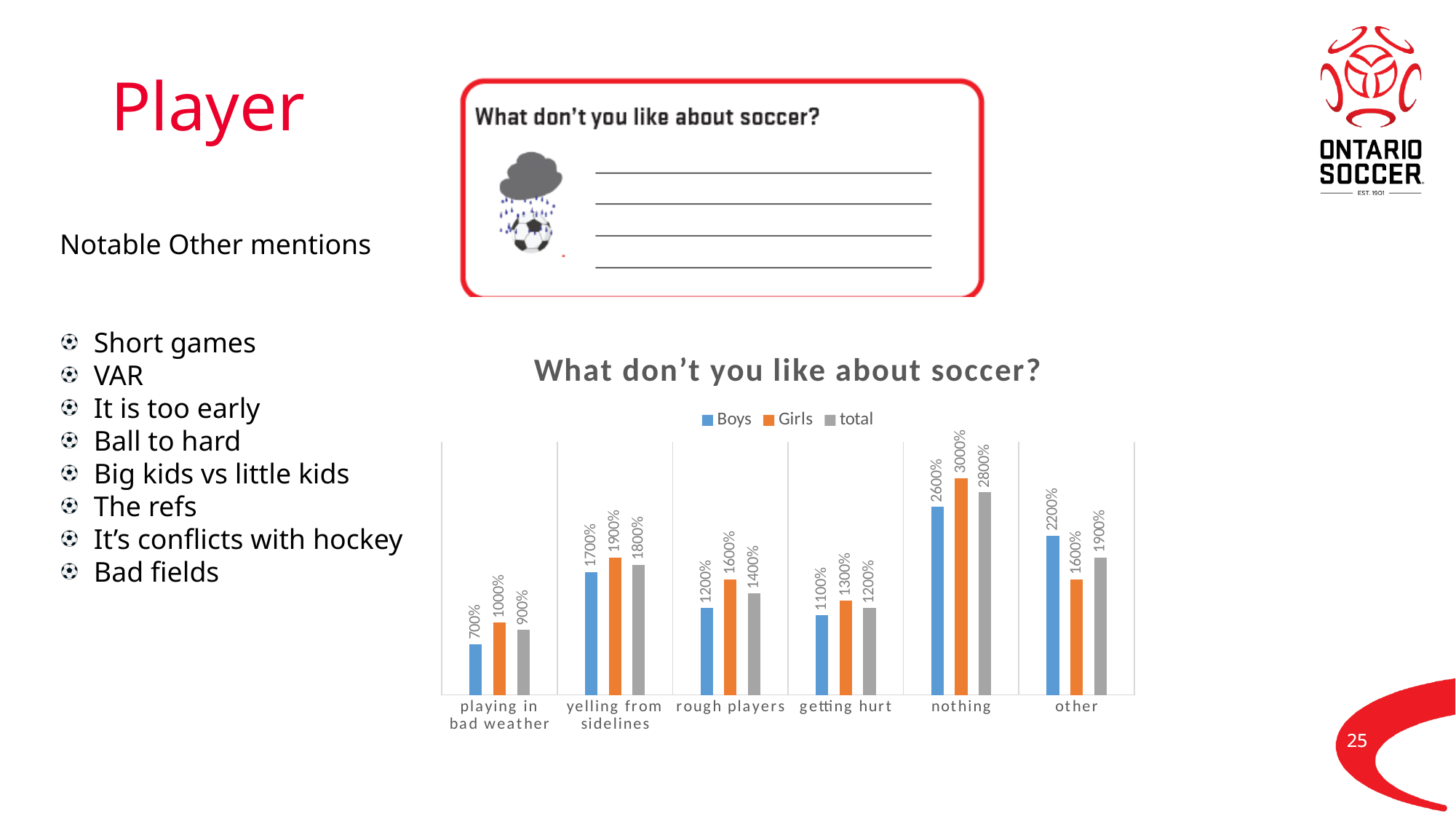
What is the title of the chart? What don't you like about soccer? What is the Boys value for "nothing"? 2600% For "other", which is larger: the Boys value or the Girls value? Boys What is the total value for "playing in bad weather"? 900% What is the Girls value for "rough players"? 1600% Which category has the highest Girls value? nothing What kind of chart is shown? Bar chart What is the Girls value for "other"? 1600% How many series does the legend list? 3 Which category has the lowest Boys value? playing in bad weather How many categories are shown on the x axis? 6 What is the difference between the Girls and Boys values for "yelling from sidelines"? 200%